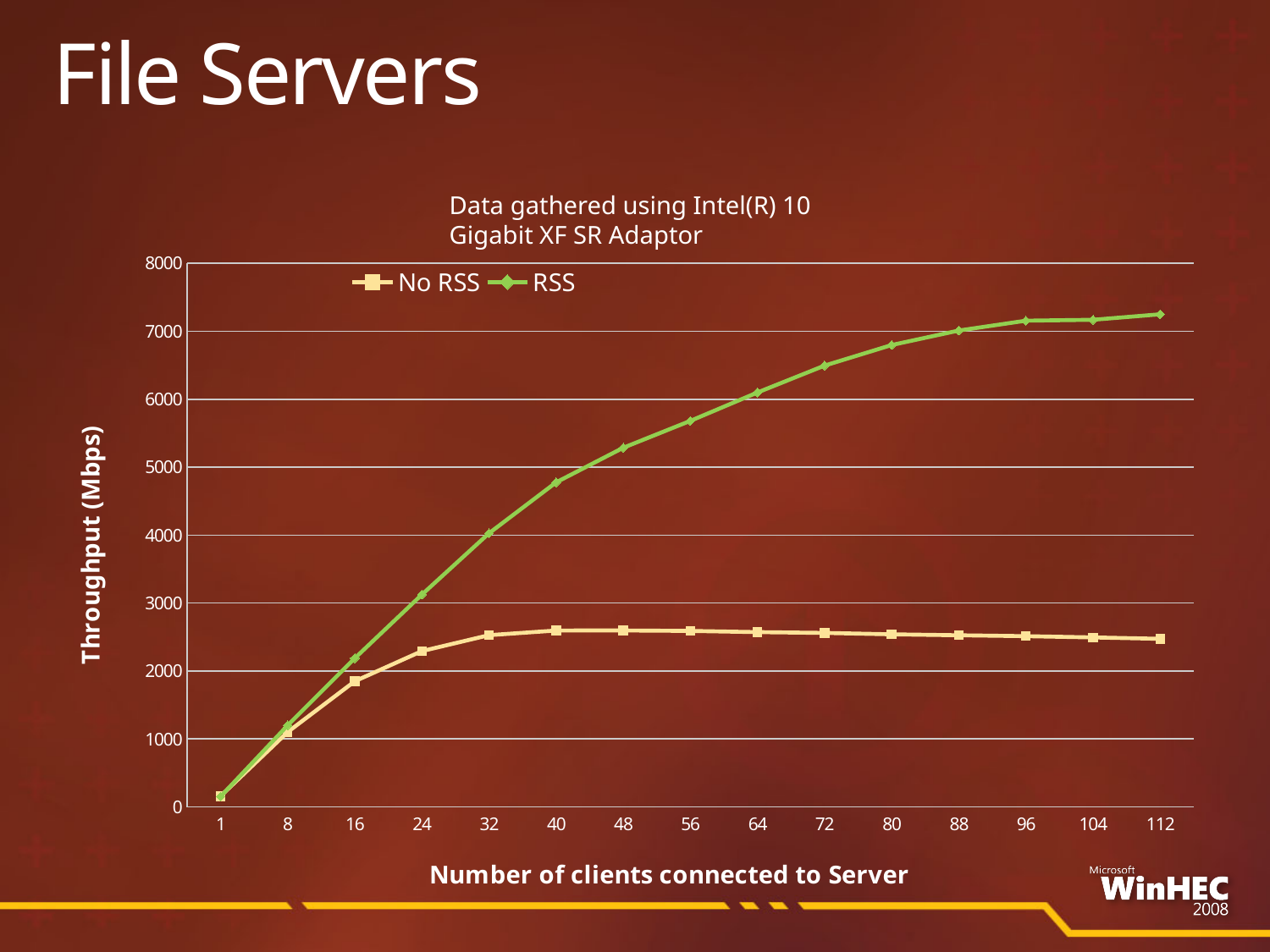
What is the label on the y axis? Throughput (Mbps) Is the No RSS throughput at 112 clients greater or less than 3000? less How many client-count points are shown along the x axis? 15 Is the RSS throughput at 48 clients greater or less than 5000? greater At which number of clients does the RSS series reach its highest throughput? 112 Is the No RSS throughput at 16 clients greater or less than 2000? less What kind of chart is shown on the slide? line chart How many series does the legend list? 2 At 112 clients, which series has the higher throughput, RSS or No RSS? RSS Does the RSS throughput rise or fall as the number of clients increases from 1 to 112? rises